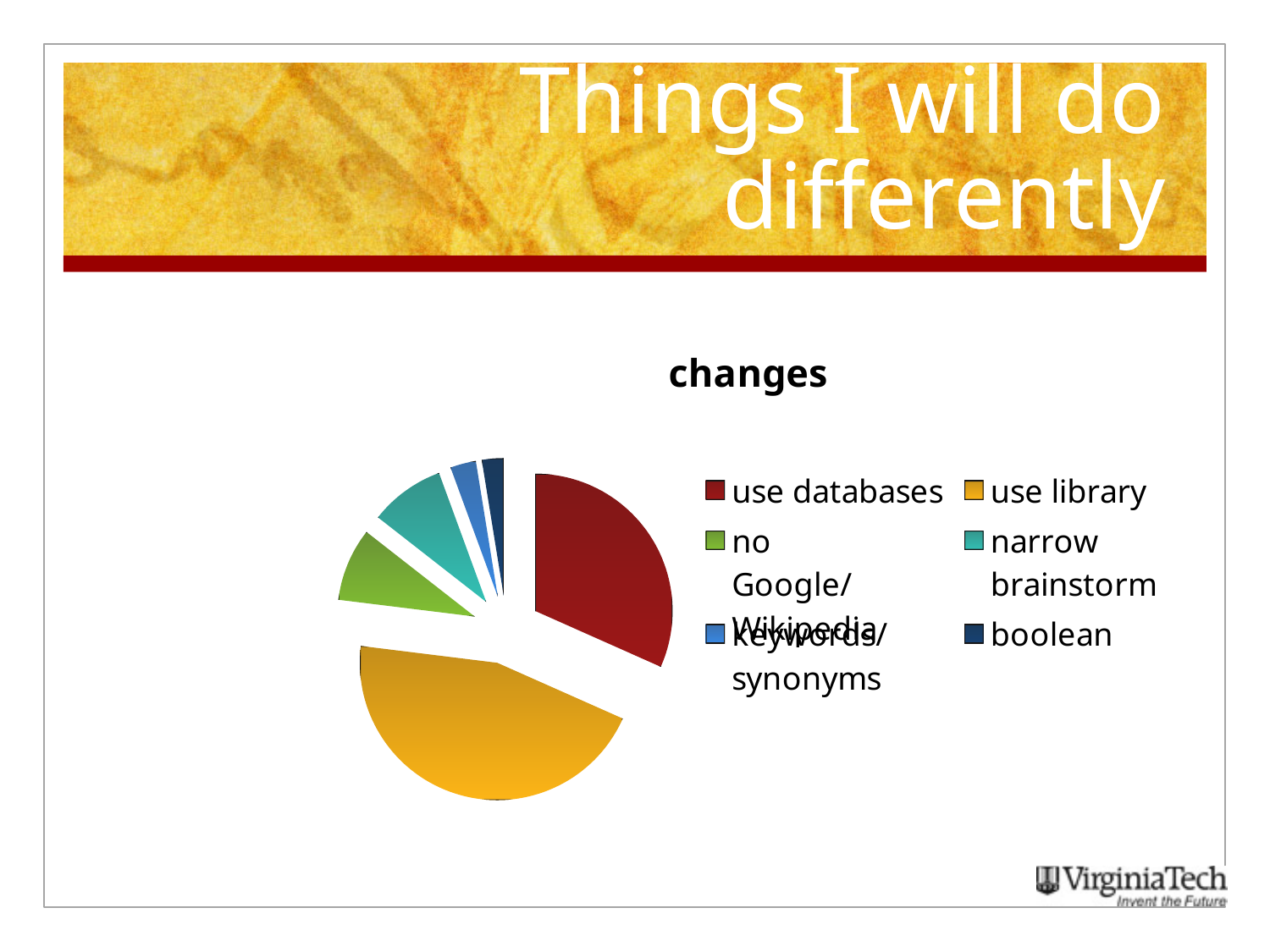
Which category has the largest slice of the pie? use library What kind of chart is shown on the slide? pie chart Which slice is larger, use databases or no Google/Wikipedia? use databases How many entries does the legend list? 6 Which slice is larger, use databases or narrow brainstorm? use databases Which slice is larger, no Google/Wikipedia or boolean? no Google/Wikipedia What colour is the use databases slice? red What is the title of the chart? changes How many slices does the pie chart have? 6